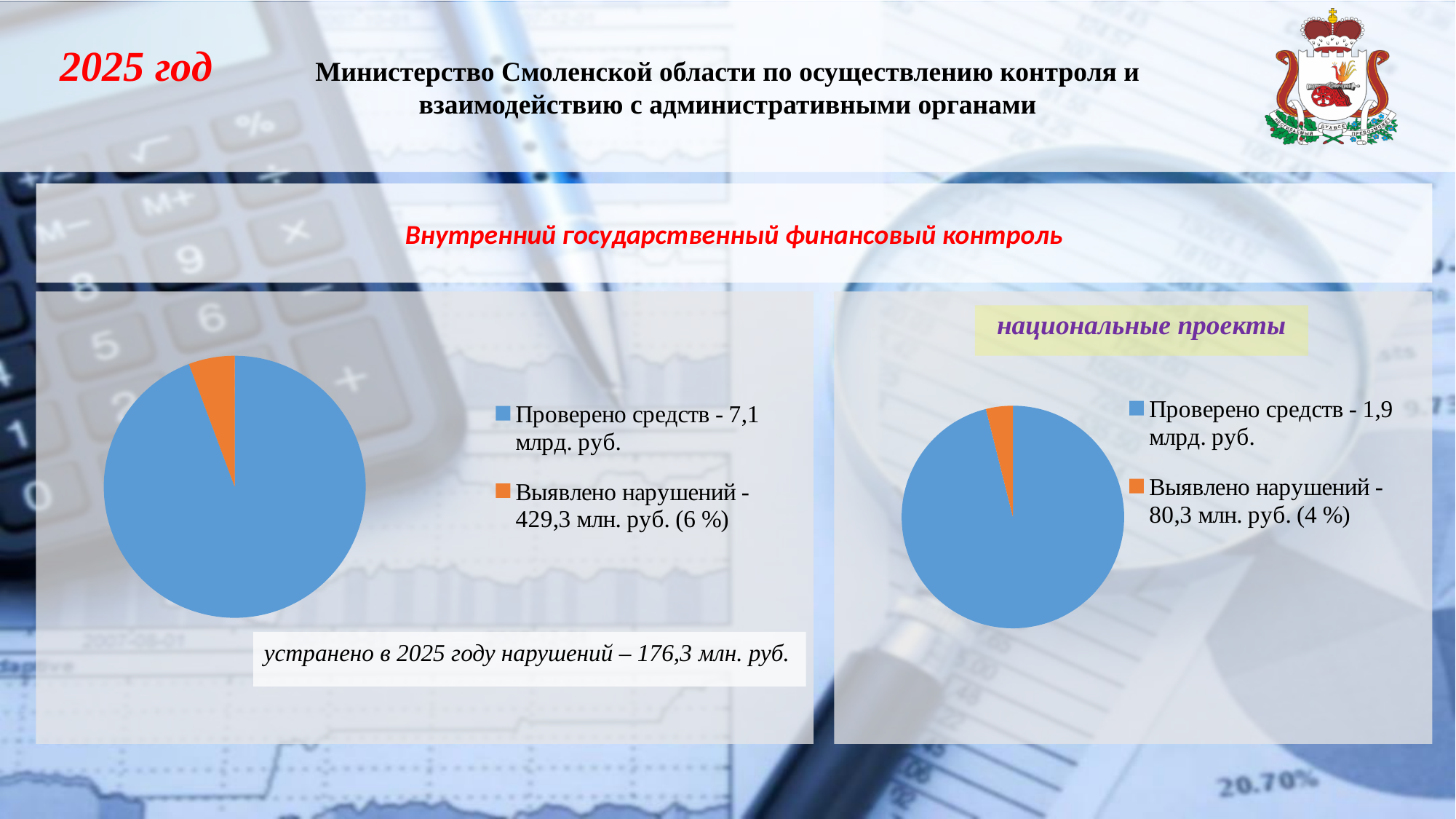
In the right pie chart ('национальные проекты'), what share of the pie does 'Выявлено нарушений' represent? 4 % What kind of chart is the right chart, under the heading 'национальные проекты'? pie chart In the right pie chart ('национальные проекты'), what amount is given for 'Выявлено нарушений'? 80,3 млн. руб. In the right pie chart ('национальные проекты'), what colour is the 'Выявлено нарушений' slice? orange What kind of chart is the left chart on the slide? pie chart In the right pie chart ('национальные проекты'), what amount is given for 'Проверено средств'? 1,9 млрд. руб. In the left pie chart, which slice is the largest? Проверено средств In the right pie chart ('национальные проекты'), which slice is the smallest? Выявлено нарушений In the left pie chart, what share of the pie does 'Выявлено нарушений' represent? 6 % How many slices does the left pie chart have? 2 In the left pie chart, what amount is given for 'Выявлено нарушений'? 429,3 млн. руб. In the left pie chart, what amount is given for 'Проверено средств'? 7,1 млрд. руб.